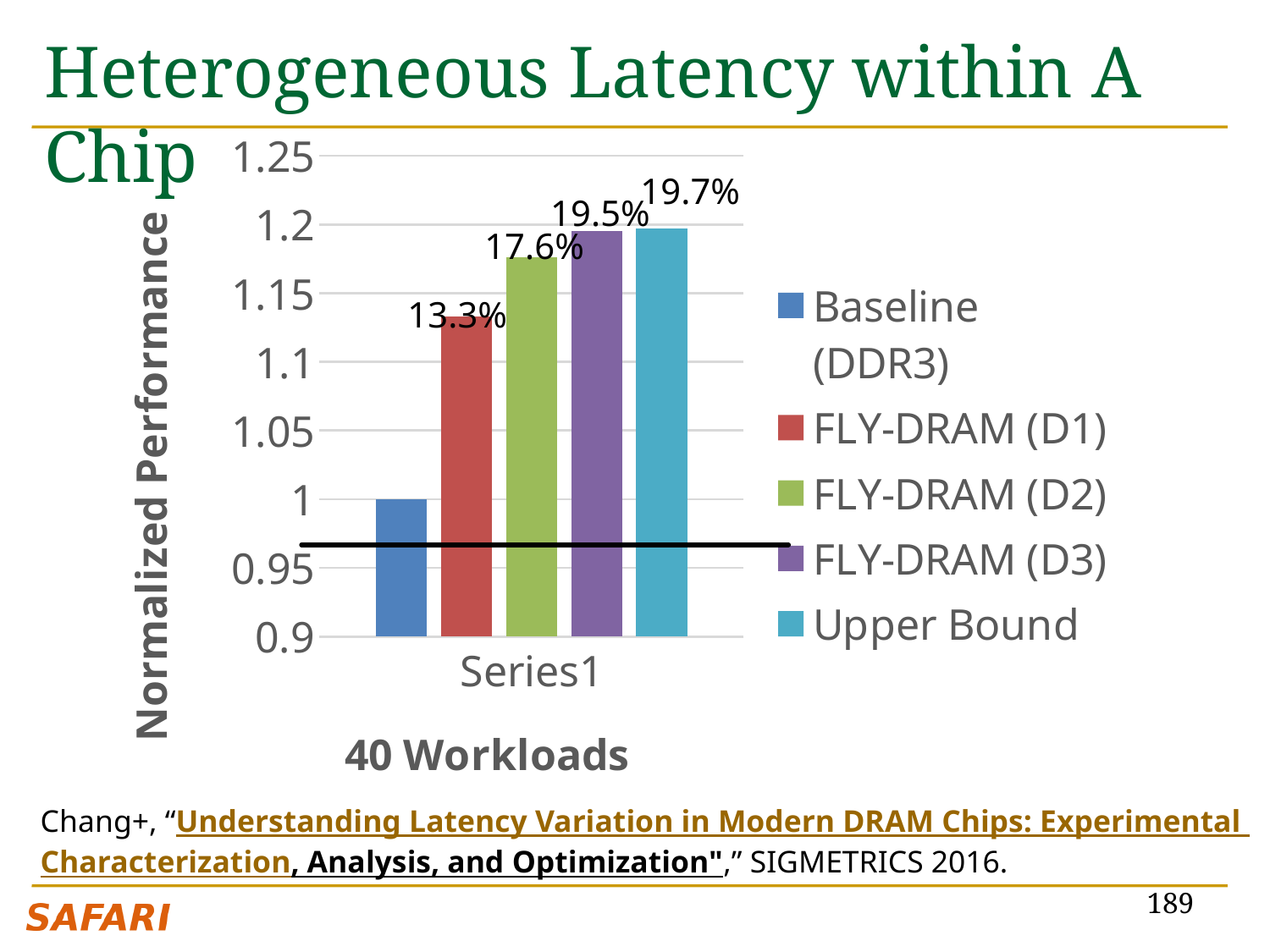
How many series does the legend list? 5 What is the difference between the percentage labels on the FLY-DRAM (D2) and FLY-DRAM (D1) bars? 4.3% What normalized performance value does the Baseline (DDR3) bar reach? 1 Which series has the shortest bar? Baseline (DDR3) Is the value for Baseline (DDR3) greater or less than 1.1? less Which series has the tallest bar? Upper Bound What kind of chart is shown on the slide? Bar chart What data label is shown on the FLY-DRAM (D2) bar? 17.6% What data label is shown on the Upper Bound bar? 19.7% Which bar is taller, FLY-DRAM (D1) or FLY-DRAM (D2)? FLY-DRAM (D2) What data label is shown on the FLY-DRAM (D3) bar? 19.5% What data label is shown on the FLY-DRAM (D1) bar? 13.3%